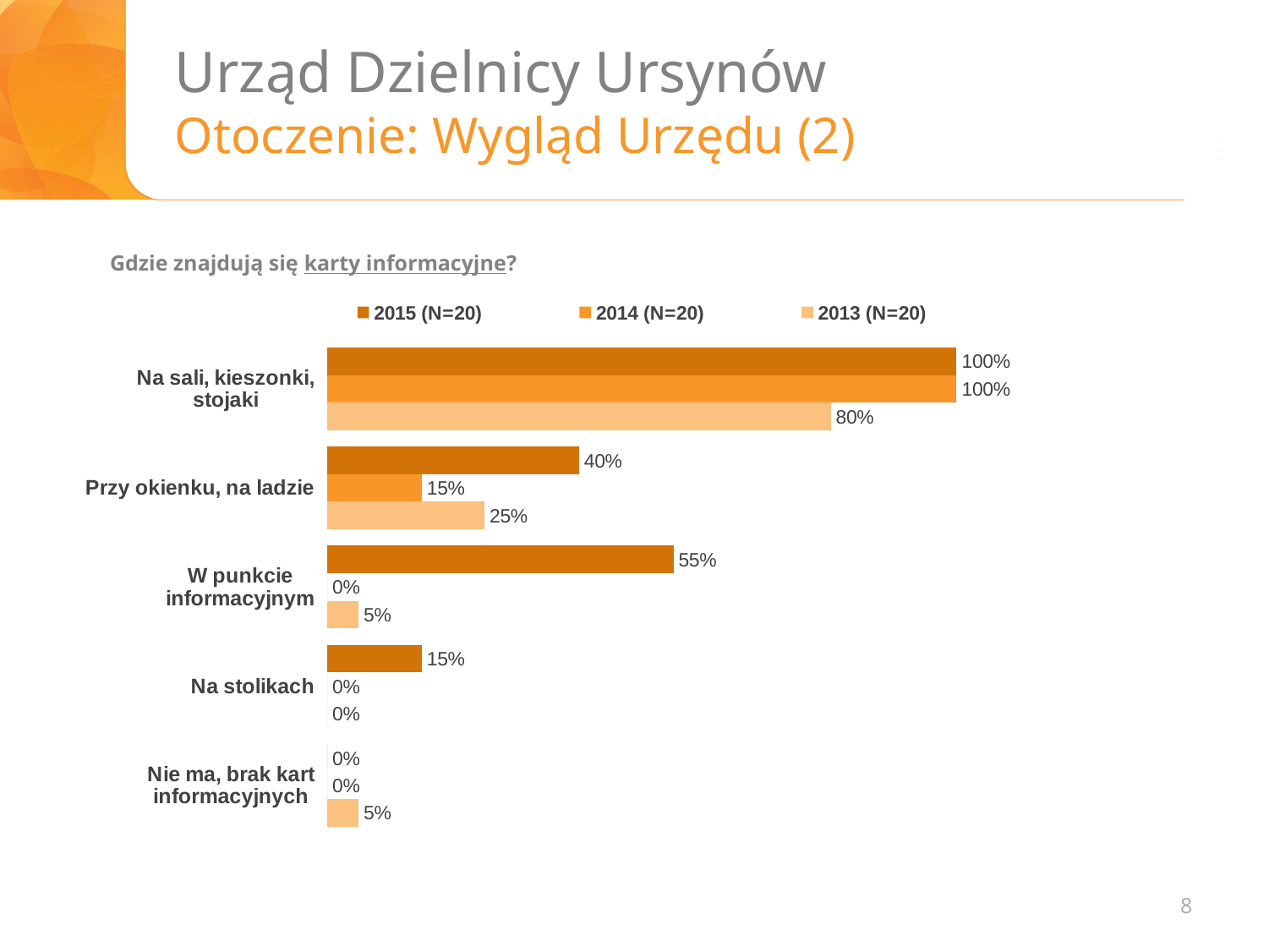
How many series does the legend list? 3 What question does the chart answer, as stated above it? Gdzie znajdują się karty informacyjne? What is the difference between the 2015 (N=20) and 2014 (N=20) values for 'Przy okienku, na ladzie'? 25% Which category has the lowest value in the 2015 (N=20) series? Nie ma, brak kart informacyjnych What kind of chart is shown on the slide? Bar chart Which is larger for 'Przy okienku, na ladzie': the 2014 (N=20) value or the 2013 (N=20) value? 2013 (N=20) Which category has the highest value in the 2015 (N=20) series? Na sali, kieszonki, stojaki How many categories are shown on the chart? 5 What is the value for 'Na sali, kieszonki, stojaki' in the 2013 (N=20) series? 80% What is the value for 'Przy okienku, na ladzie' in the 2015 (N=20) series? 40% What is the value for 'W punkcie informacyjnym' in the 2014 (N=20) series? 0% What is the value for 'Na stolikach' in the 2015 (N=20) series? 15%